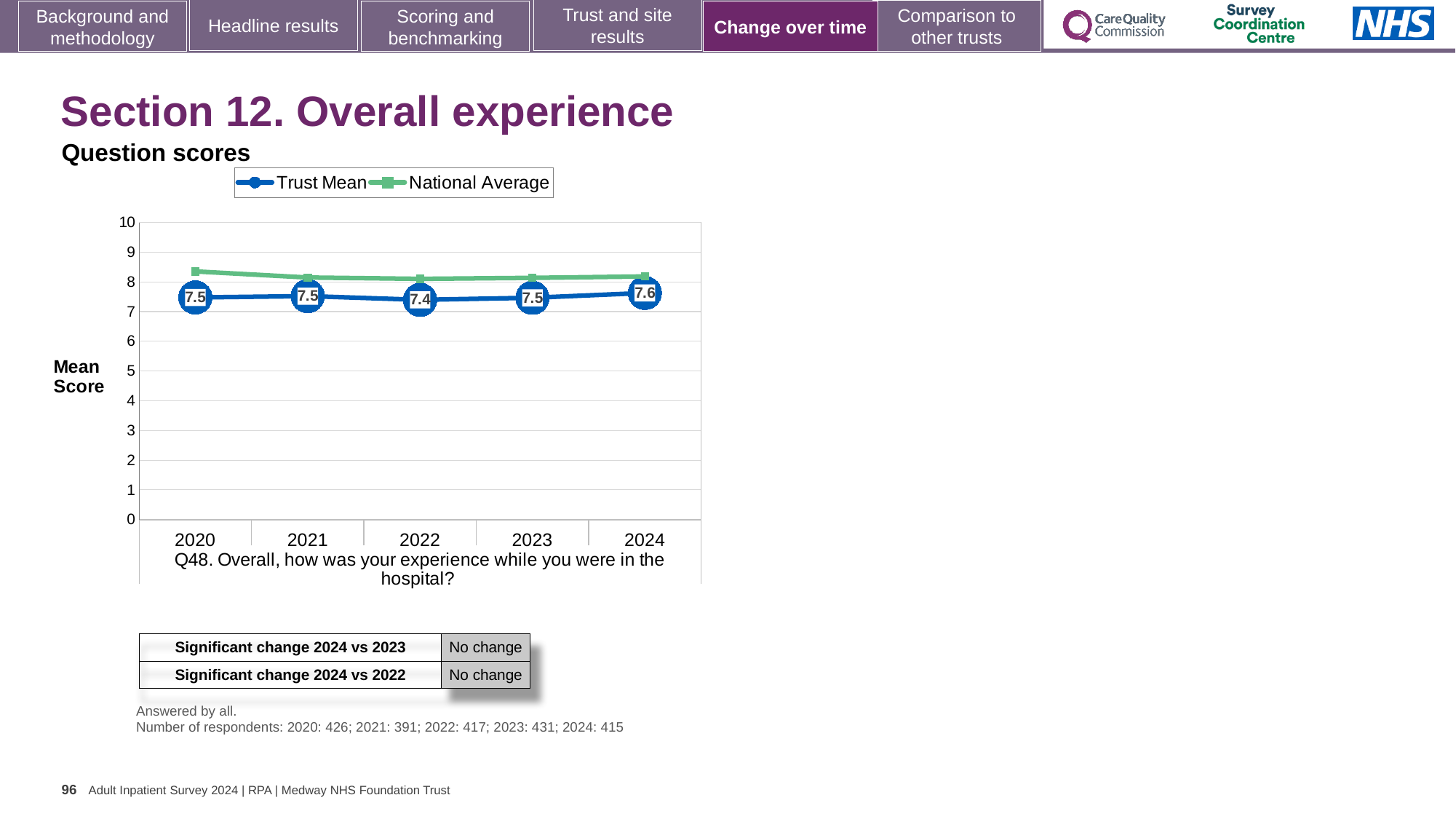
What is the Trust Mean score for 2022? 7.4 What is the difference between the Trust Mean score in 2024 and in 2022? 0.2 How many years are plotted on the x axis of the chart? 5 In which year is the Trust Mean score highest? 2024 How many series does the chart legend list? 2 What kind of chart is shown on the slide? Line chart Does the Trust Mean score rise or fall from 2022 to 2024? Rise In which year is the Trust Mean score lowest? 2022 What is the Trust Mean score for 2020? 7.5 In 2020, which is higher: the Trust Mean or the National Average? National Average What is the Trust Mean score for 2024? 7.6 Is the National Average value for 2020 greater or less than 8? greater